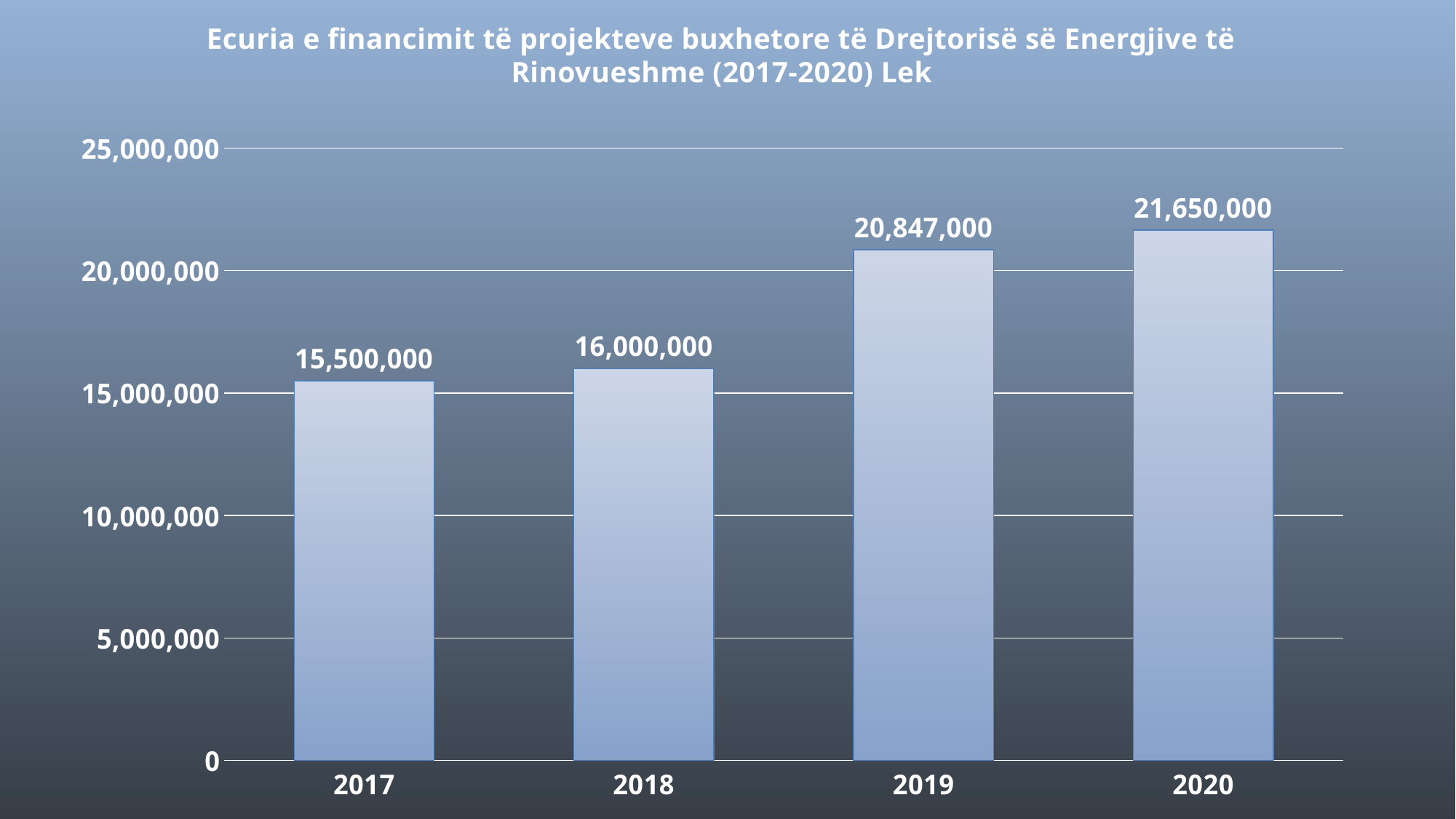
What is the difference between the values for 2020 and 2019? 803,000 Which is larger, the value for 2018 or the value for 2019? 2019 Do the values rise or fall from 2017 to 2020? rise Which year has the lowest value? 2017 What is the value for 2019? 20,847,000 What is the value for 2020? 21,650,000 What is the value for 2017? 15,500,000 Is the value for 2019 greater or less than 20,000,000? greater Which year has the highest value? 2020 How many years are shown on the chart? 4 What kind of chart is this? bar chart What is the difference between the values for 2018 and 2017? 500,000